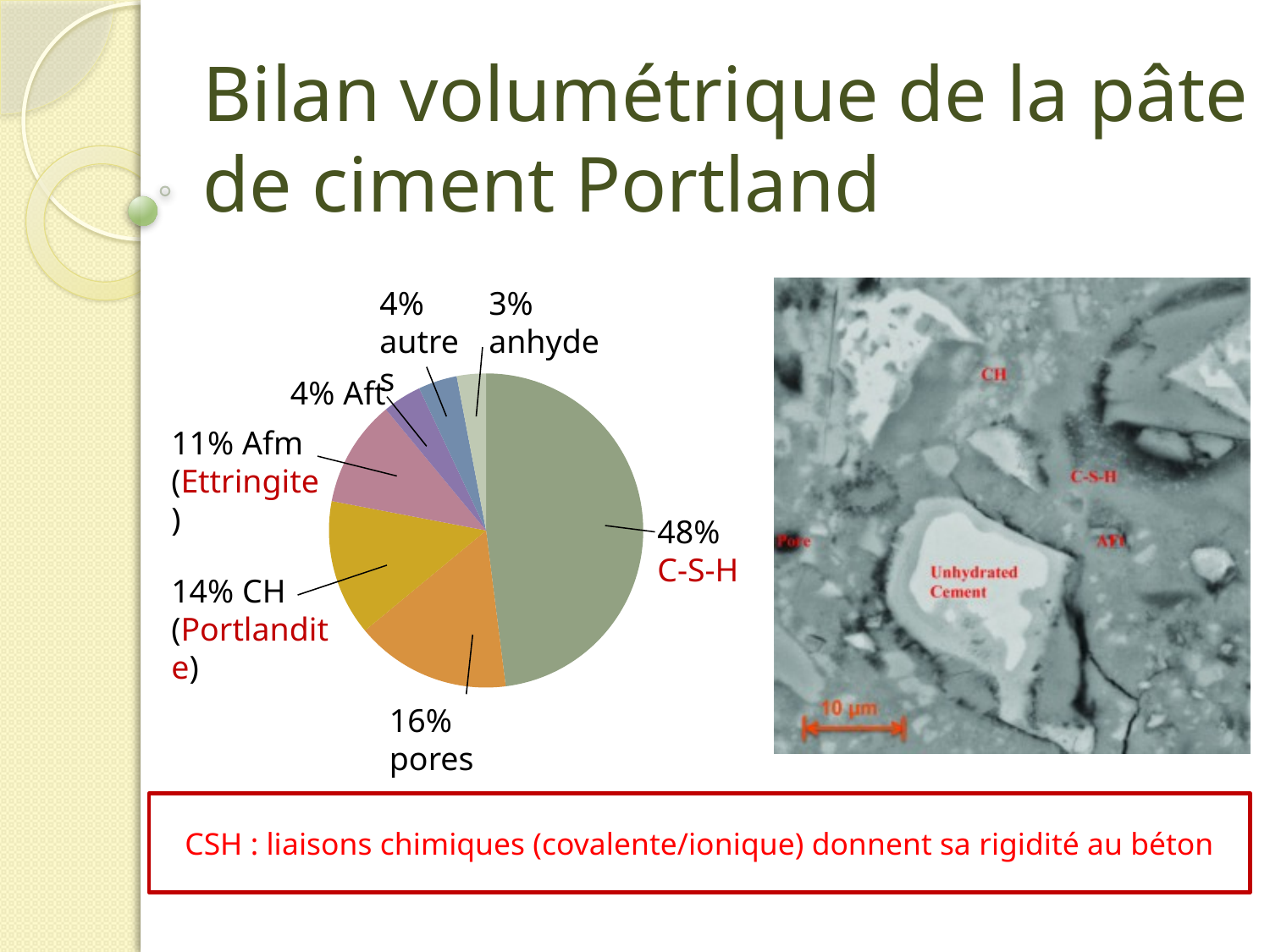
Which is larger, the share for CH (Portlandite) or the share for Afm (Ettringite)? CH (Portlandite) What is the title of the slide containing the pie chart? Bilan volumétrique de la pâte de ciment Portland What percentage is shown for CH (Portlandite)? 14% What percentage is shown for anhyde? 3% How many slices does the pie chart have? 7 What kind of chart is shown on the slide? pie chart Which slice of the pie is the smallest? anhyde What is the difference in percentage points between C-S-H and pores? 32 What percentage is shown for Afm (Ettringite)? 11% What share of the pie does C-S-H represent? 48% What percentage of the pie is labelled pores? 16% Which slice of the pie is the largest? C-S-H